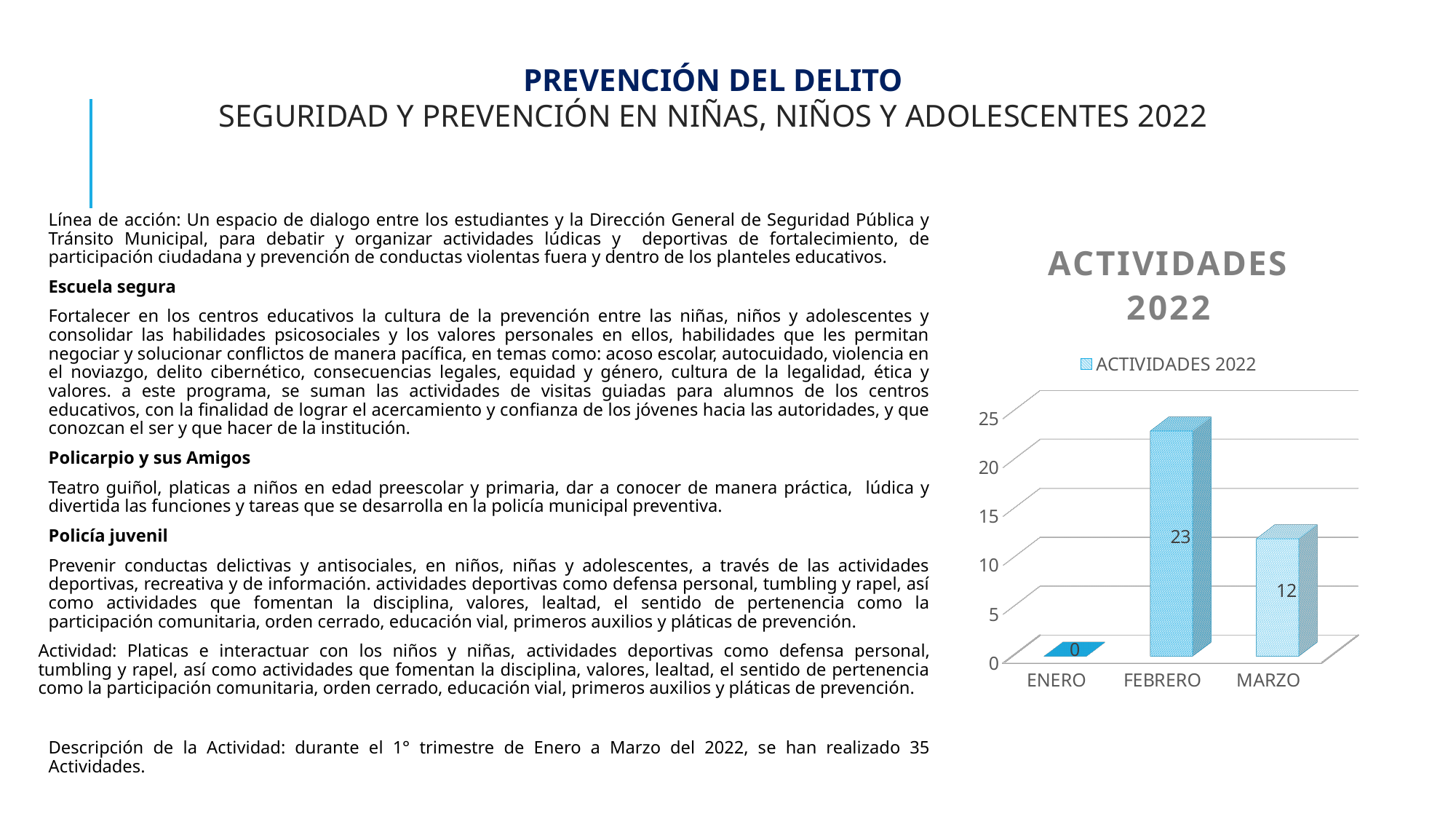
Which month has the highest value in the ACTIVIDADES 2022 chart? FEBRERO What is the value for MARZO in the ACTIVIDADES 2022 chart? 12 What kind of chart is the ACTIVIDADES 2022 chart? bar chart Is the value for FEBRERO in the ACTIVIDADES 2022 chart greater or less than 20? greater What is the value for FEBRERO in the ACTIVIDADES 2022 chart? 23 Which is larger in the ACTIVIDADES 2022 chart, the value for FEBRERO or the value for MARZO? FEBRERO How many series does the legend of the ACTIVIDADES 2022 chart list? 1 What is the value for ENERO in the ACTIVIDADES 2022 chart? 0 Which month has the lowest value in the ACTIVIDADES 2022 chart? ENERO What is the title of the chart on the slide? ACTIVIDADES 2022 What is the difference between the values for FEBRERO and MARZO in the ACTIVIDADES 2022 chart? 11 How many months are shown on the x axis of the ACTIVIDADES 2022 chart? 3